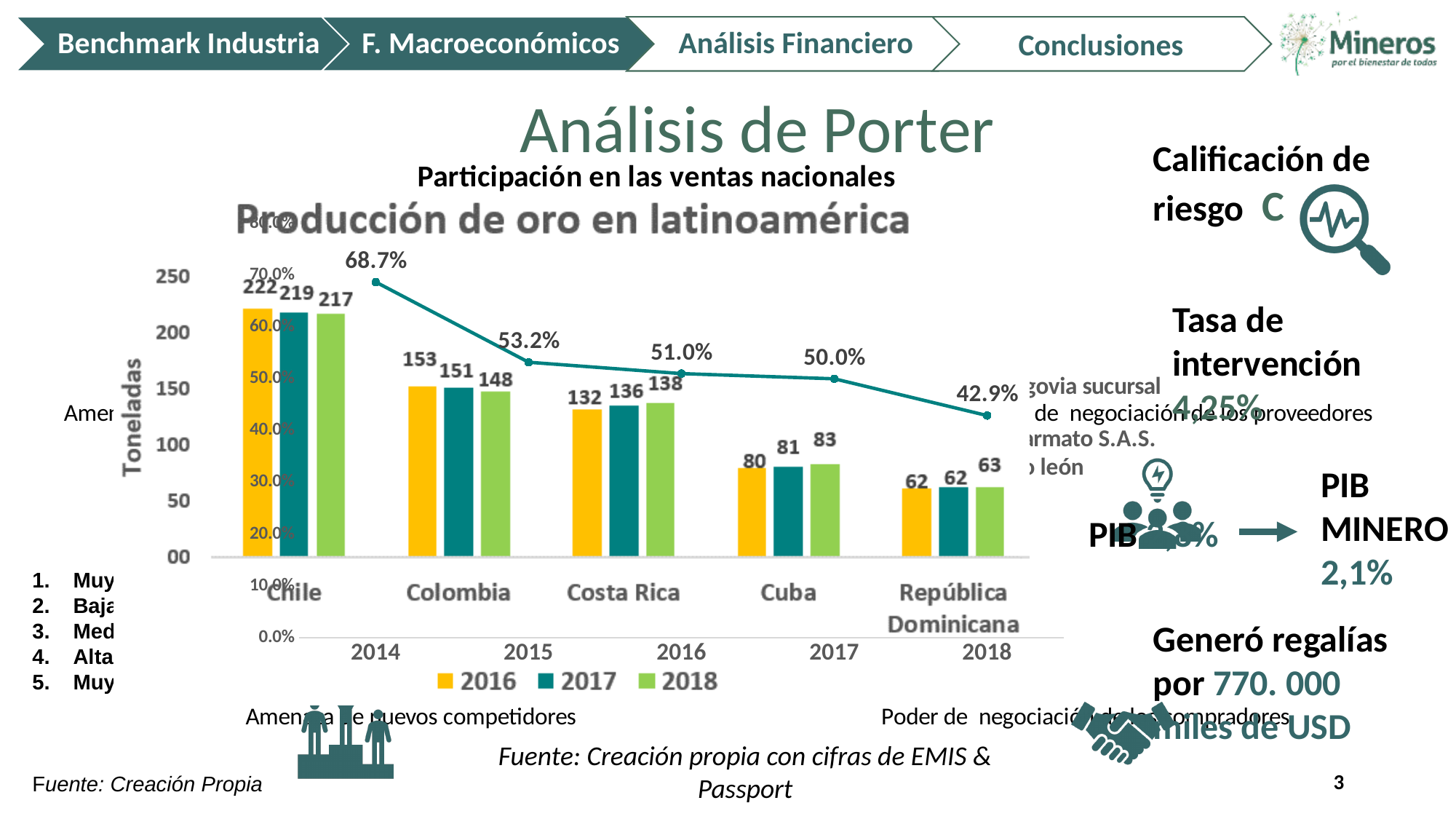
In the 'Producción de oro en latinoamérica' chart, how many series does the legend list? 3 In the 'Participación en las ventas nacionales' chart, do the values rise or fall from 2014 to 2018? Fall In the 'Producción de oro en latinoamérica' chart, which country has the lowest production in 2018? República Dominicana In the 'Participación en las ventas nacionales' chart, what is the value for 2018? 42.9% In the 'Producción de oro en latinoamérica' chart, what is the value for Chile in 2016? 222 In the 'Producción de oro en latinoamérica' chart, which country has the highest production in 2017? Chile In the 'Producción de oro en latinoamérica' chart, what is the difference between Colombia's 2016 value and Cuba's 2016 value? 73 What kind of chart is 'Producción de oro en latinoamérica'? Bar chart In the 'Producción de oro en latinoamérica' chart, how many countries are shown on the x axis? 5 In the 'Producción de oro en latinoamérica' chart, what is the value for Costa Rica in 2018? 138 In the 'Participación en las ventas nacionales' chart, what is the value for 2014? 68.7% In the 'Participación en las ventas nacionales' chart, what is the difference between the 2014 value and the 2015 value? 15.5%